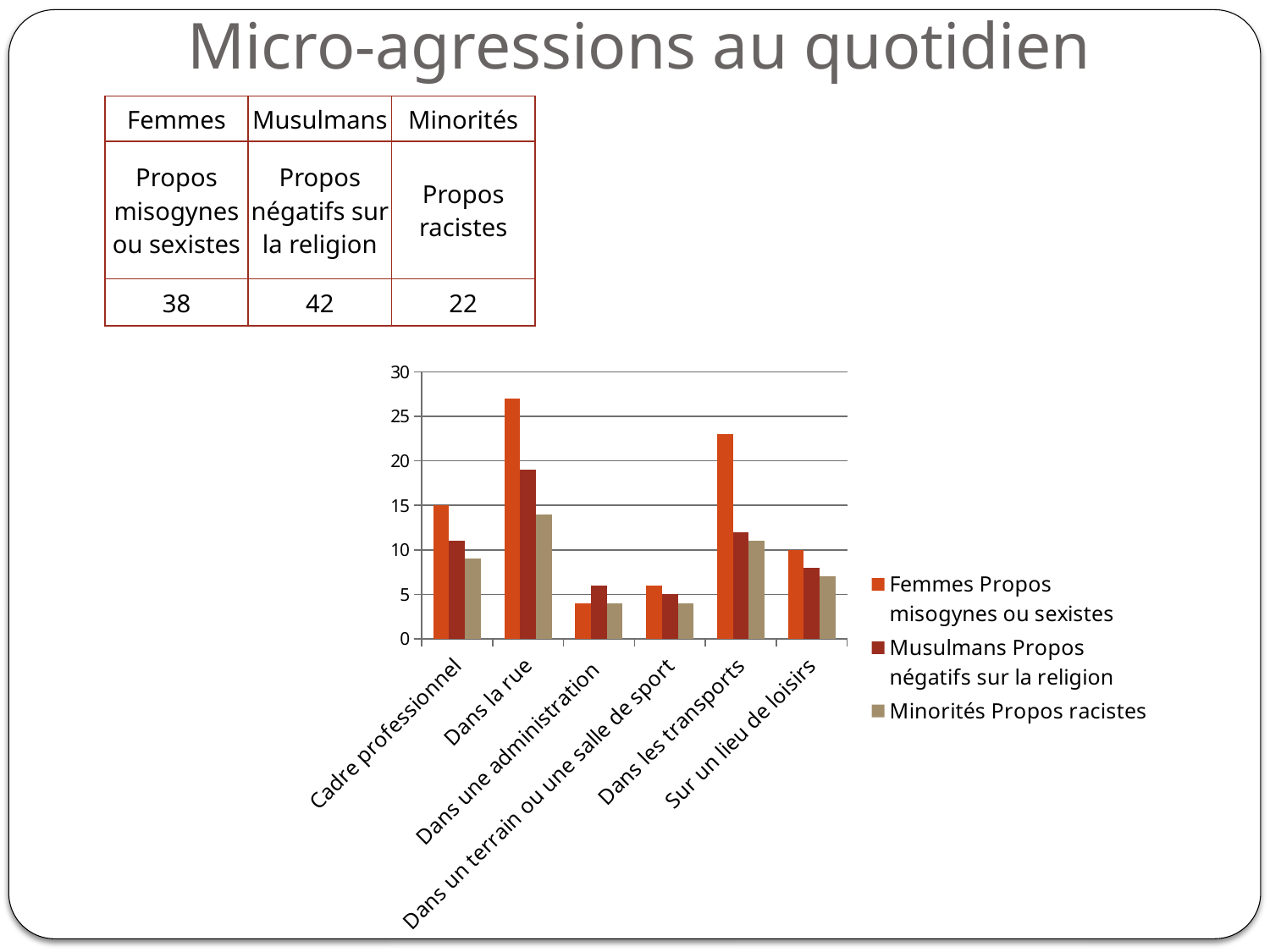
Is the value for 'Minorités Propos racistes' in 'Dans une administration' greater or less than 5? less What is the value for 'Femmes Propos misogynes ou sexistes' in the 'Sur un lieu de loisirs' category? 10 Which category has the highest value for 'Femmes Propos misogynes ou sexistes'? Dans la rue What kind of chart is shown on the slide? bar chart What is the value for 'Femmes Propos misogynes ou sexistes' in the 'Cadre professionnel' category? 15 Which series is shown in the lightest (tan) colour in the chart's legend? Minorités Propos racistes How many categories are shown on the x axis of the chart? 6 Is the value for 'Musulmans Propos négatifs sur la religion' in 'Dans les transports' greater or less than 10? greater In the 'Cadre professionnel' category, which is larger: the value for 'Femmes Propos misogynes ou sexistes' or for 'Musulmans Propos négatifs sur la religion'? Femmes Propos misogynes ou sexistes Which category has the highest value for 'Musulmans Propos négatifs sur la religion'? Dans la rue Is the value for 'Femmes Propos misogynes ou sexistes' in 'Dans la rue' greater or less than 25? greater How many series does the chart's legend list? 3